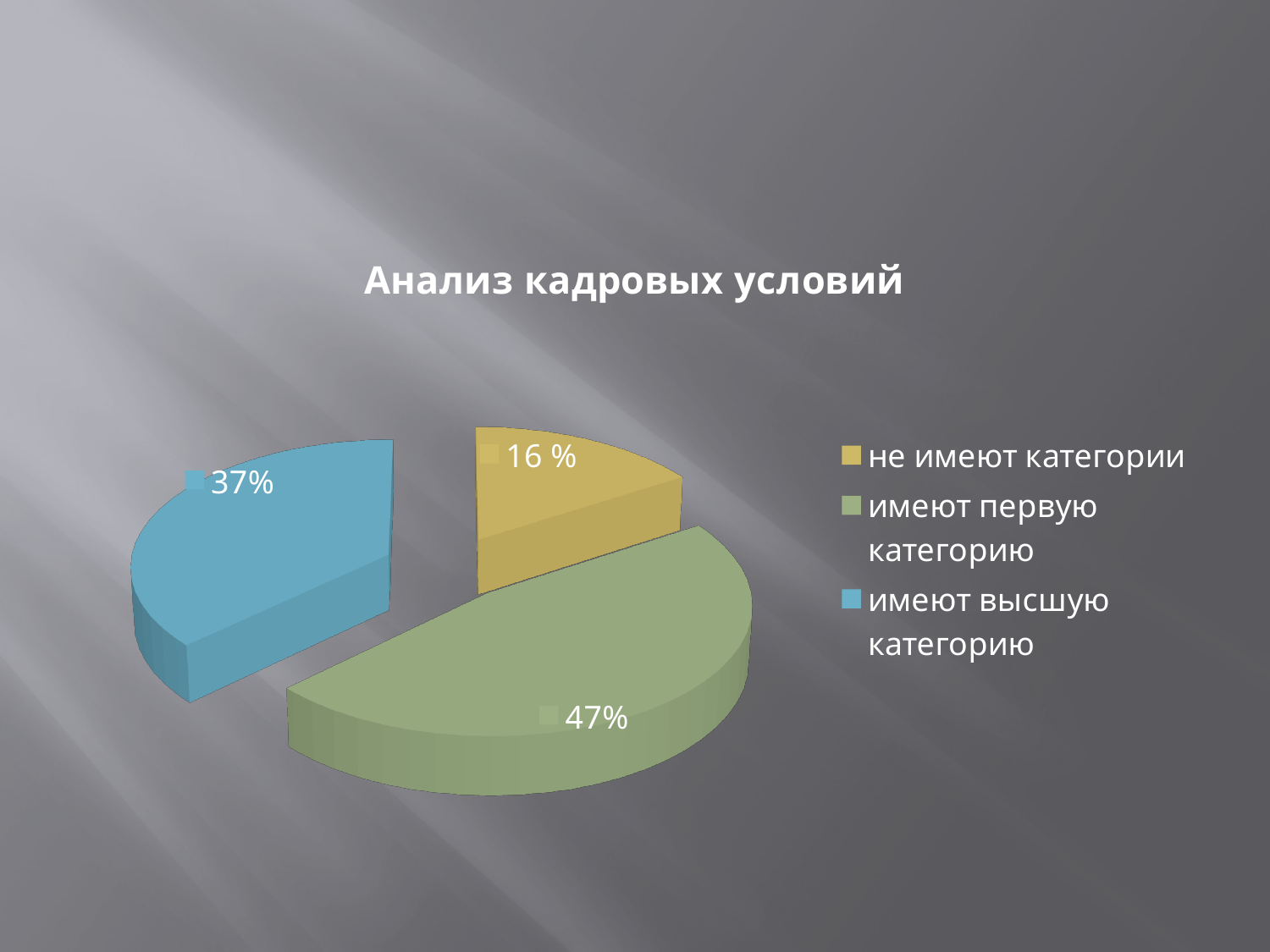
What kind of chart is shown on the slide? pie chart How many entries does the legend list? 3 How many slices does the pie chart have? 3 Which category has the smallest slice of the pie? не имеют категории What is the value for "не имеют категории"? 16 % What is the value for "имеют высшую категорию"? 37% Which category has the largest slice of the pie? имеют первую категорию What is the title of the chart? Анализ кадровых условий Which is larger: the slice for "имеют высшую категорию" or the slice for "не имеют категории"? имеют высшую категорию What is the difference between the values for "имеют первую категорию" and "имеют высшую категорию"? 10% What is the value for "имеют первую категорию"? 47% What colour is the slice for "имеют высшую категорию"? blue